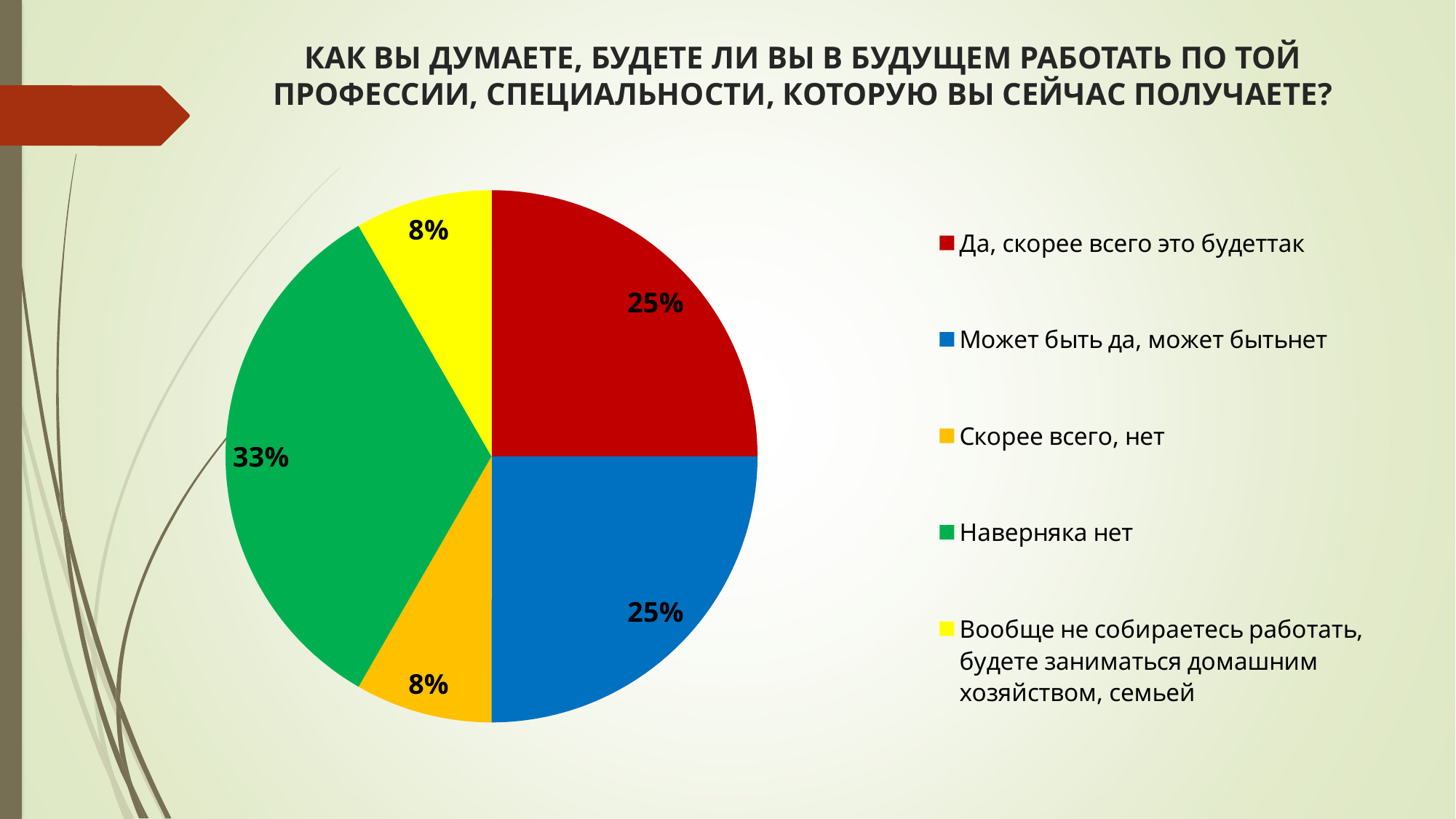
What kind of chart is shown on the slide? pie chart What share of the pie does "Наверняка нет" have? 33% What share of the pie does "Может быть да, может быть нет" have? 25% What share of the pie does "Да, скорее всего это будет так" have? 25% What colour is the slice for "Может быть да, может быть нет"? blue Which category has the largest slice of the pie? Наверняка нет How many categories does the legend list? 5 Which is larger: the share for "Наверняка нет" or the share for "Да, скорее всего это будет так"? Наверняка нет What is the difference between the share for "Наверняка нет" and the share for "Скорее всего, нет"? 25% What colour is the slice for "Наверняка нет"? green What is the difference between the share for "Да, скорее всего это будет так" and the share for "Вообще не собираетесь работать, будете заниматься домашним хозяйством, семьей"? 17%